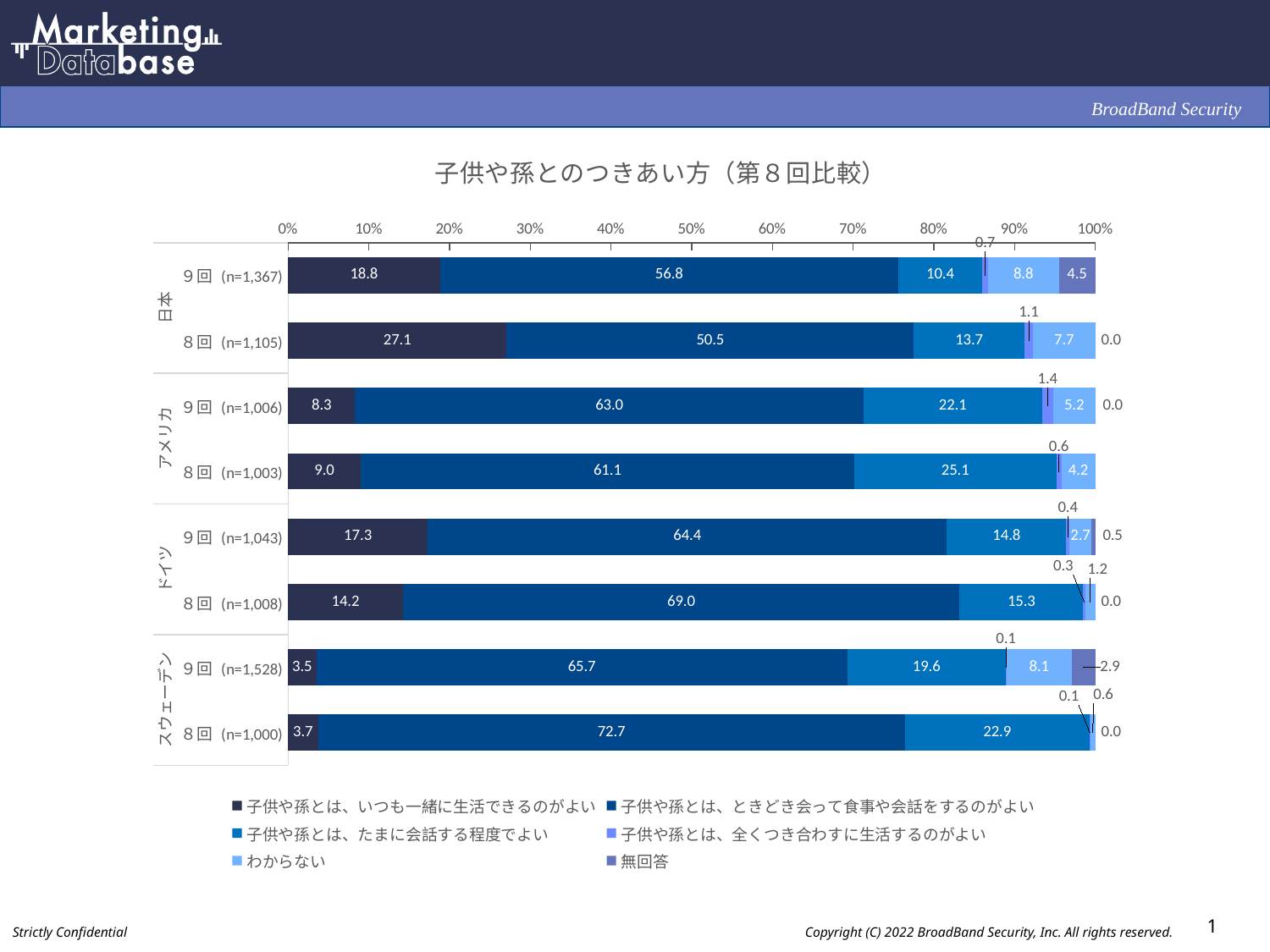
How many series does the legend list? 6 What is the value of 「子供や孫とは、ときどき会って食事や会話をするのがよい」 for 日本 9回 (n=1,367)? 56.8 Which bar has the lowest value for 「子供や孫とは、いつも一緒に生活できるのがよい」? スウェーデン 9回 (n=1,528) What is the difference in 「子供や孫とは、ときどき会って食事や会話をするのがよい」 between ドイツ 8回 (n=1,008) and ドイツ 9回 (n=1,043)? 4.6 What type of chart is shown on the slide? Stacked bar chart How many bars (survey rows) are plotted in the chart? 8 What is the value of 「子供や孫とは、ときどき会って食事や会話をするのがよい」 for スウェーデン 8回 (n=1,000)? 72.7 Which is larger: 「わからない」 for 日本 9回 (n=1,367) or for スウェーデン 9回 (n=1,528)? 日本 9回 (n=1,367) What is the value of 「子供や孫とは、たまに会話する程度でよい」 for アメリカ 8回 (n=1,003)? 25.1 What is the value of 「子供や孫とは、いつも一緒に生活できるのがよい」 for 日本 8回 (n=1,105)? 27.1 Which bar has the highest value for 「子供や孫とは、いつも一緒に生活できるのがよい」? 日本 8回 (n=1,105) What is the title of the chart? 子供や孫とのつきあい方（第８回比較）